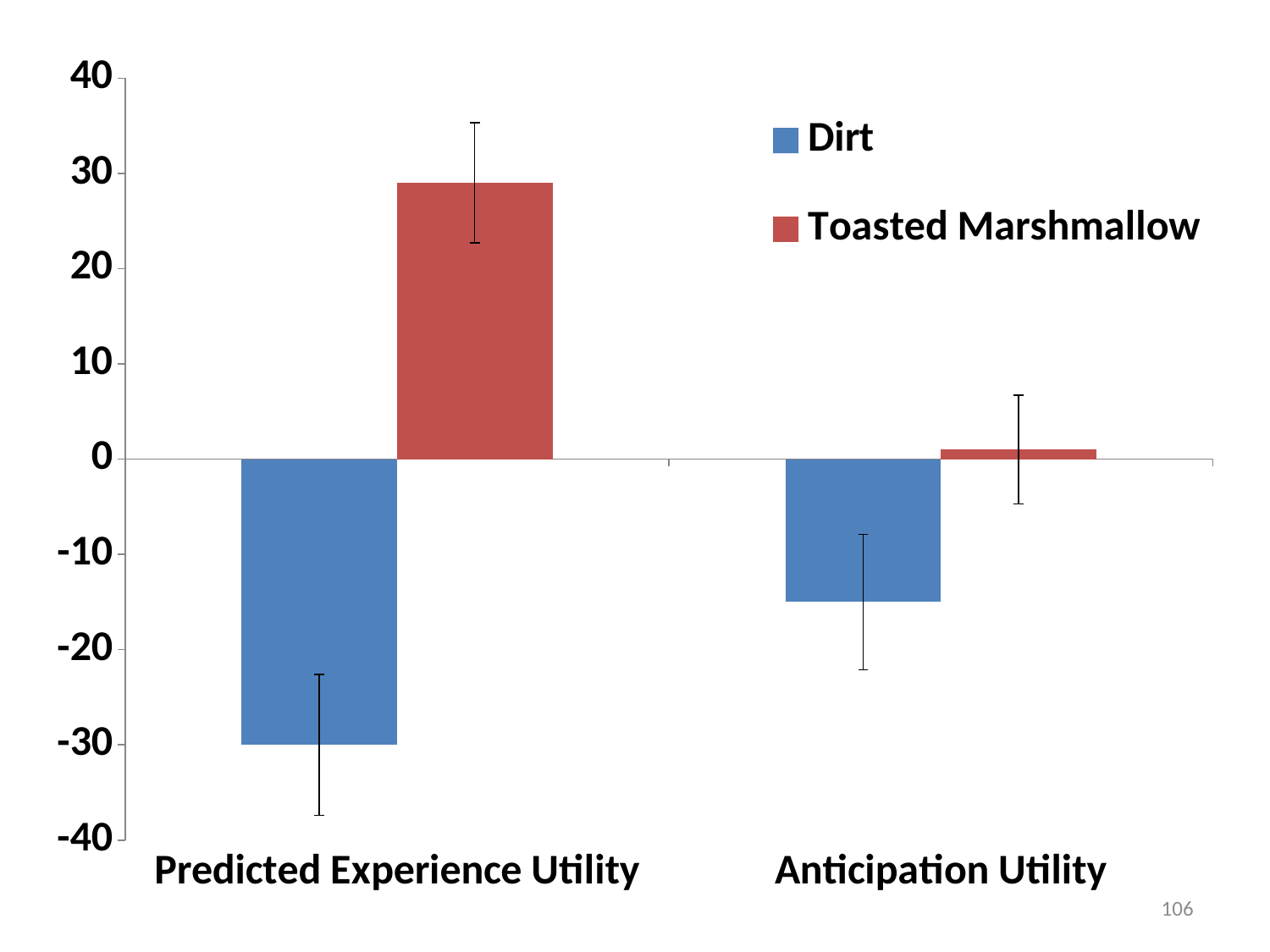
Is the value for Toasted Marshmallow in Anticipation Utility greater or less than 10? less What colour represents the Dirt series in the legend? Blue Is the value for Toasted Marshmallow in Predicted Experience Utility greater or less than 20? greater Which series has the highest bar on the chart? Toasted Marshmallow For Predicted Experience Utility, which series has the larger value, Dirt or Toasted Marshmallow? Toasted Marshmallow Is the value for Dirt in Anticipation Utility greater or less than -10? less How many categories are shown on the x axis? 2 How many series does the legend list? 2 Which category and series has the lowest bar on the chart? Dirt, Predicted Experience Utility For Anticipation Utility, which series has the larger value, Dirt or Toasted Marshmallow? Toasted Marshmallow What type of chart is shown on the slide? Bar chart